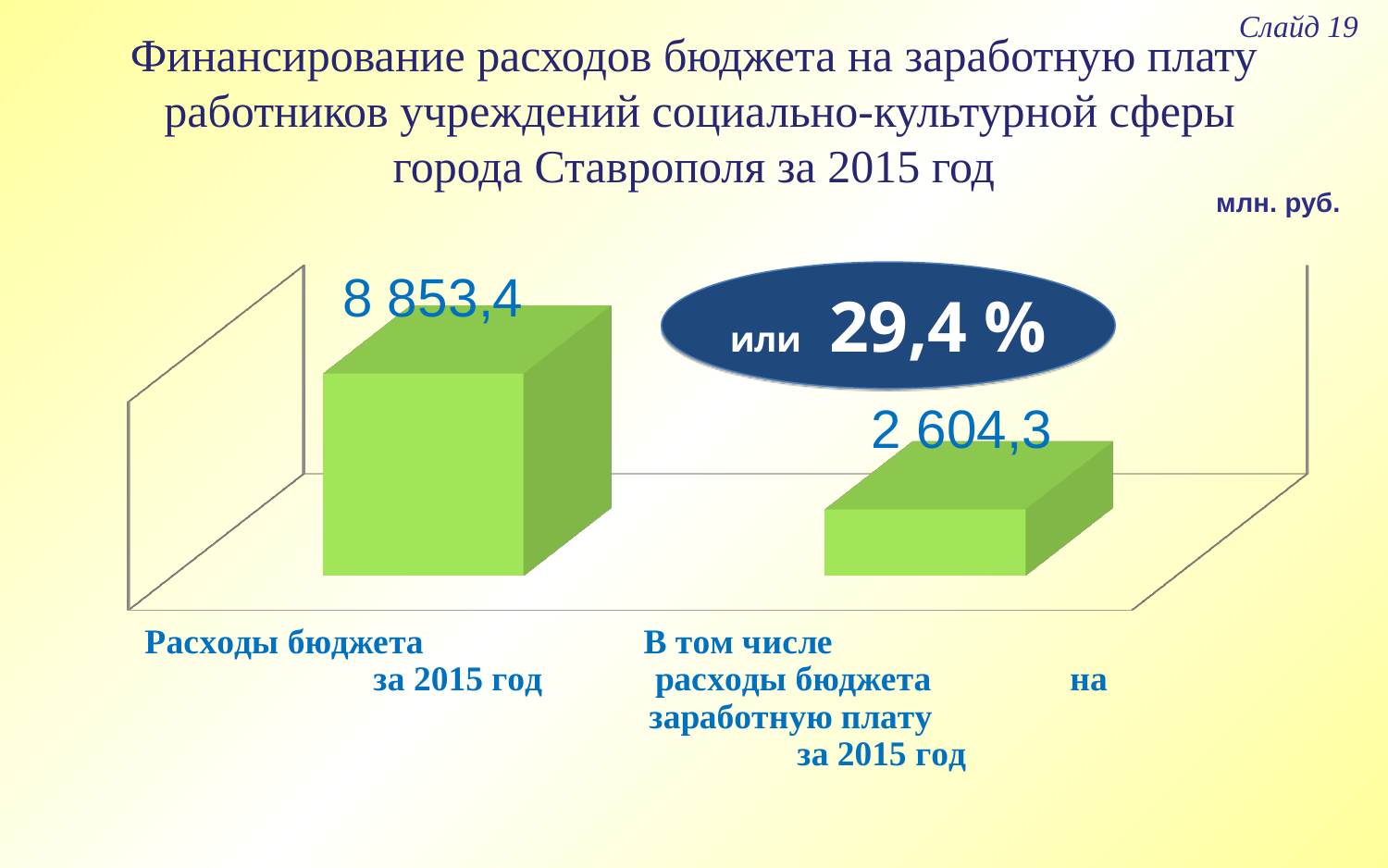
Which is larger: «Расходы бюджета за 2015 год» or «В том числе расходы бюджета на заработную плату за 2015 год»? Расходы бюджета за 2015 год What is the value for «Расходы бюджета за 2015 год»? 8 853,4 What kind of chart is shown on the slide? Bar chart Which category has the highest value? Расходы бюджета за 2015 год What unit of measurement is indicated for the chart values? млн. руб. What is the value for «В том числе расходы бюджета на заработную плату за 2015 год»? 2 604,3 Which category has the lowest value? В том числе расходы бюджета на заработную плату за 2015 год Do the values rise or fall from left to right? Fall What is the difference between «Расходы бюджета за 2015 год» and «В том числе расходы бюджета на заработную плату за 2015 год»? 6 249,1 How many bars are shown in the chart? 2 What percentage is shown in the oval callout on the chart? 29,4 %